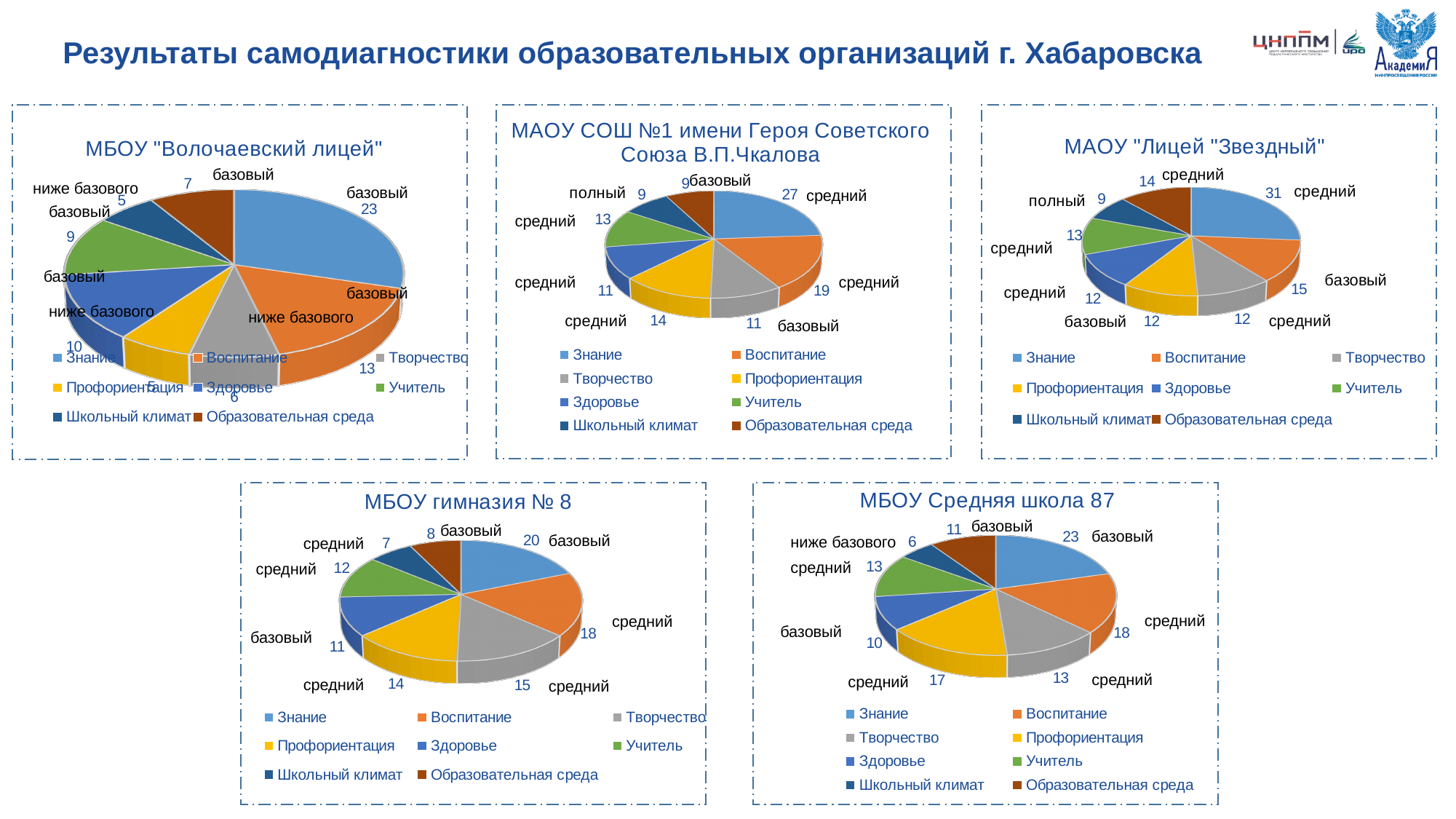
In the МАОУ "Лицей "Звездный" chart, what is the difference between the values for Знание and Воспитание? 16 How many pie charts are shown on the slide? 5 What kind of chart is used for МБОУ гимназия № 8? Pie chart How many categories does the legend of the МАОУ СОШ №1 имени Героя Советского Союза В.П.Чкалова chart list? 8 In the МБОУ гимназия № 8 chart, which is larger: Творчество or Профориентация? Творчество In the МБОУ Средняя школа 87 chart, what is the value for Профориентация? 17 In the МБОУ Средняя школа 87 chart, which category has the smallest slice? Школьный климат In the МБОУ гимназия № 8 chart, which category has the largest slice? Знание In the МАОУ СОШ №1 имени Героя Советского Союза В.П.Чкалова chart, what is the value for Знание? 27 In the МБОУ "Волочаевский лицей" chart, what is the value for Знание? 23 In the МАОУ "Лицей "Звездный" chart, what is the value for Образовательная среда? 14 In the МБОУ Средняя школа 87 chart, what colour is the Профориентация slice? Yellow